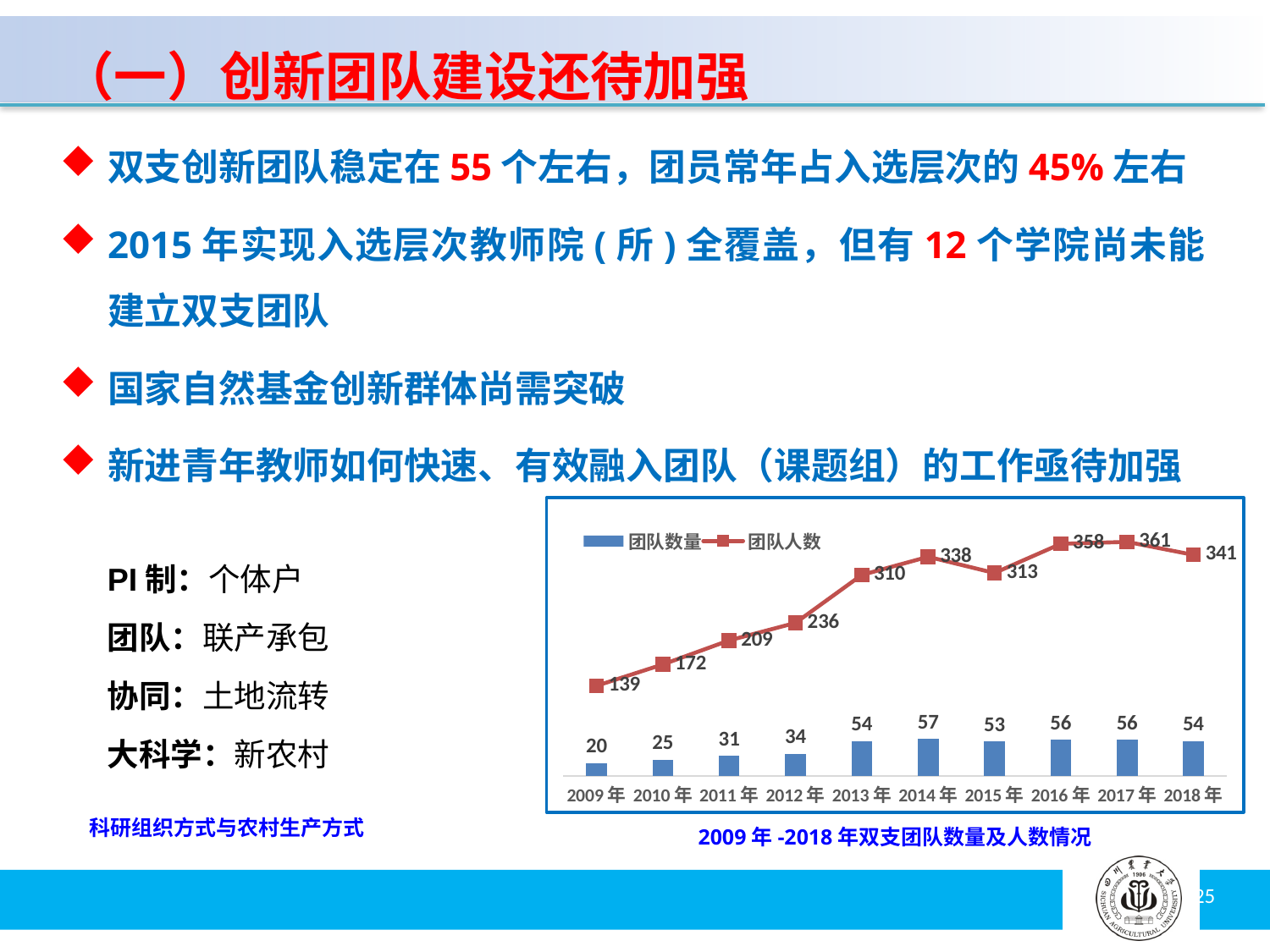
What kind of chart is this? Combined bar and line chart Which is larger, the 团队人数 for 2014年 or for 2015年? 2014年 What is the difference in 团队人数 between 2018年 and 2009年? 202 What is the difference in 团队数量 between 2014年 and 2015年? 4 Which year has the lowest 团队数量? 2009年 What is the 团队人数 value for 2009年? 139 What is the title of the chart? 2009年-2018年双支团队数量及人数情况 How many years are shown on the x axis? 10 What is the 团队数量 value for 2014年? 57 Which year has the highest 团队人数? 2017年 What is the 团队人数 value for 2017年? 361 How many series does the legend list? 2